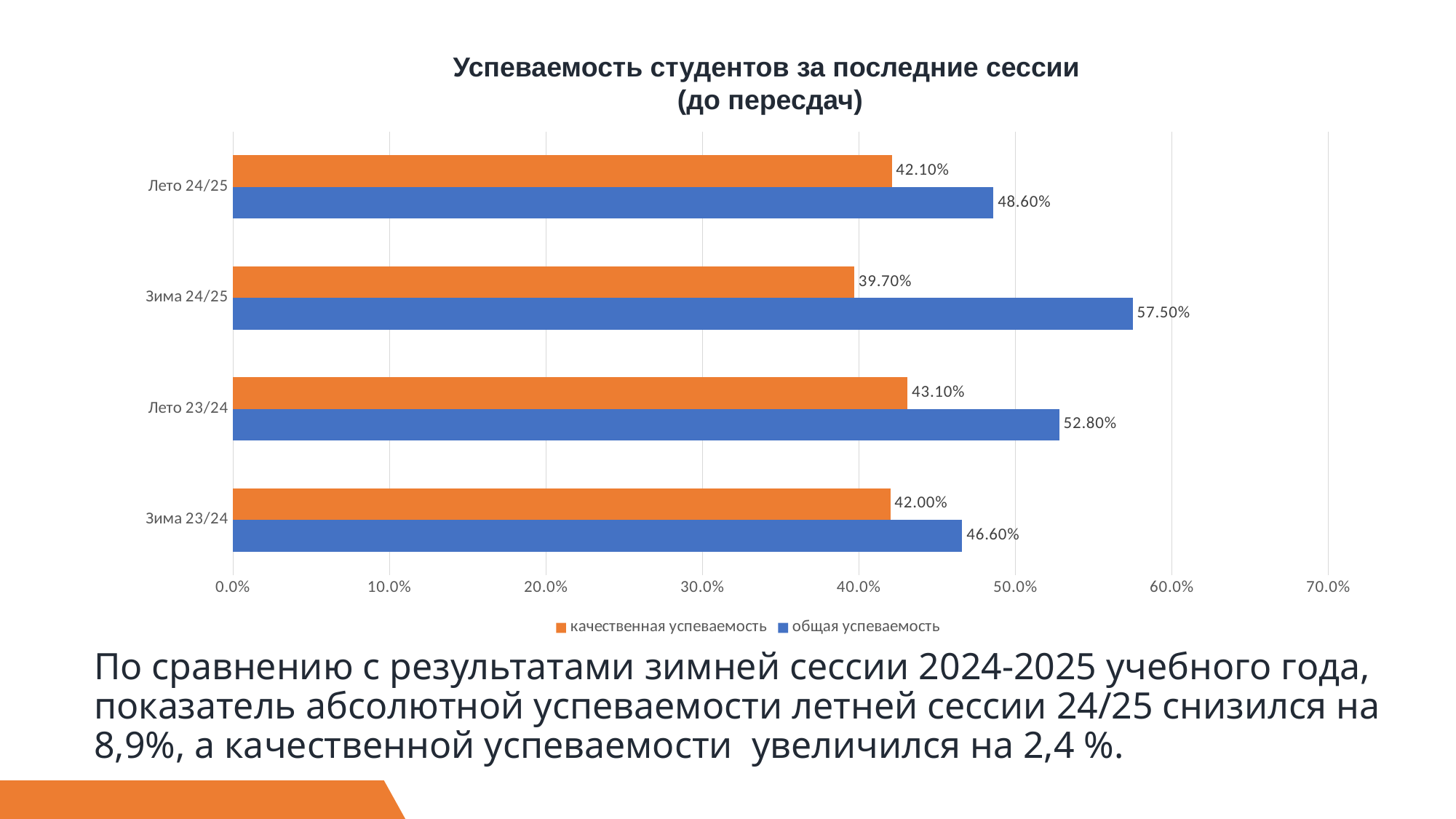
What is the качественная успеваемость value for Лето 23/24? 43.10% What is the difference in общая успеваемость between Лето 23/24 and Лето 24/25? 4.20% Which session has the lowest общая успеваемость? Зима 23/24 Which is larger: общая успеваемость for Лето 23/24 or for Зима 23/24? Лето 23/24 Which session has the highest общая успеваемость? Зима 24/25 How many sessions (categories) are shown on the chart? 4 What is the общая успеваемость value for Лето 24/25? 48.60% What is the общая успеваемость value for Зима 24/25? 57.50% What type of chart is shown on the slide? Bar chart What is the difference between общая успеваемость and качественная успеваемость for Зима 24/25? 17.80% Which session has the lowest качественная успеваемость? Зима 24/25 How many series does the legend list? 2